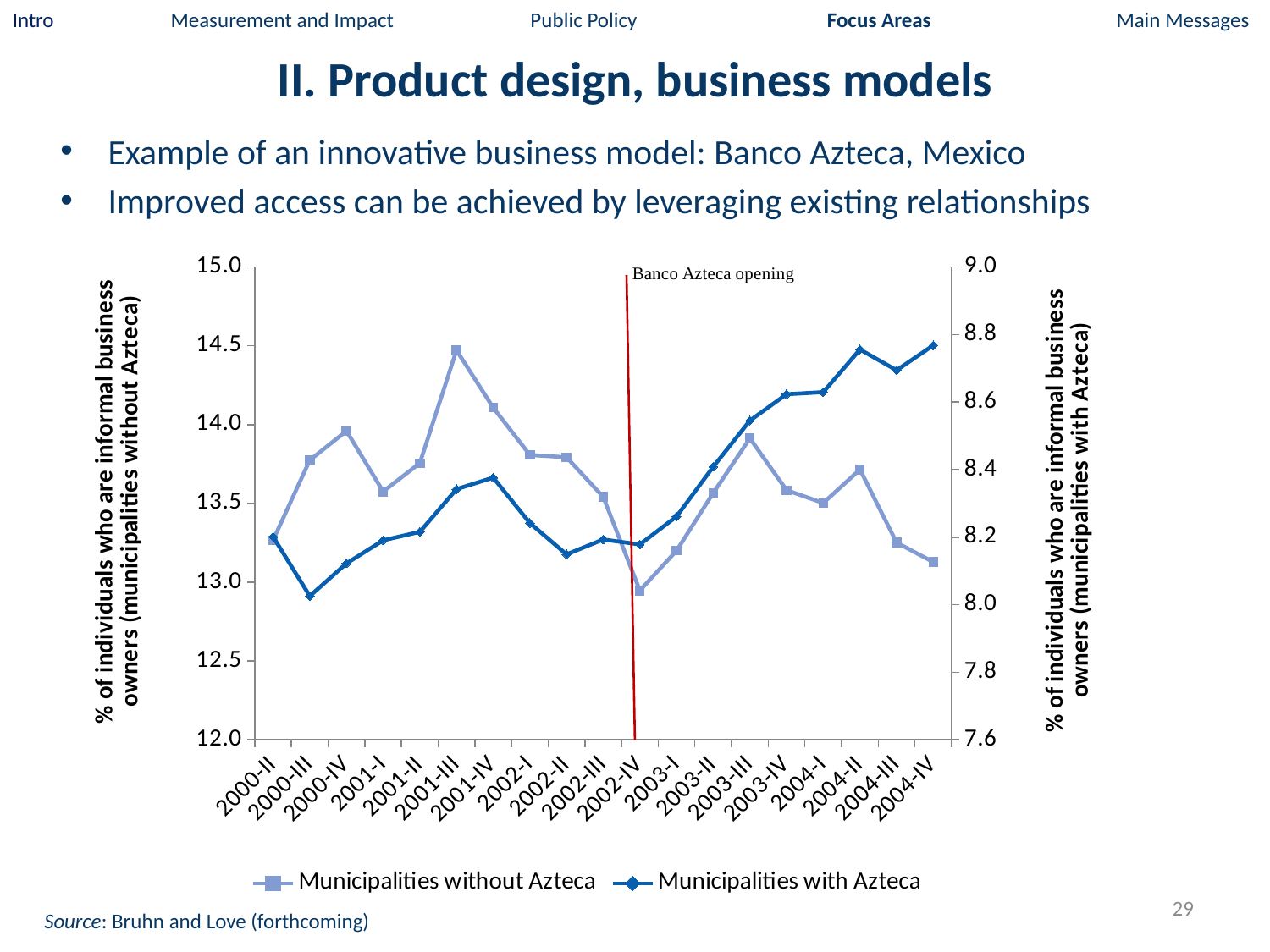
What event does the red vertical line on the chart mark? Banco Azteca opening How many time periods are plotted along the x axis? 19 Which period has the highest value for Municipalities without Azteca? 2001-III Which period has the lowest value for Municipalities without Azteca? 2002-IV Is the value for Municipalities with Azteca in 2004-IV greater or less than 8.6 on the right axis? greater How many series does the legend list? 2 Is the value for Municipalities without Azteca in 2001-III greater or less than 14.0? greater Is the value for Municipalities with Azteca in 2000-III greater or less than 8.2 on the right axis? less What kind of chart is shown on the slide? line chart Which period has the lowest value for Municipalities with Azteca? 2000-III Does the Municipalities with Azteca line rise or fall from 2002-IV to 2004-IV? rise